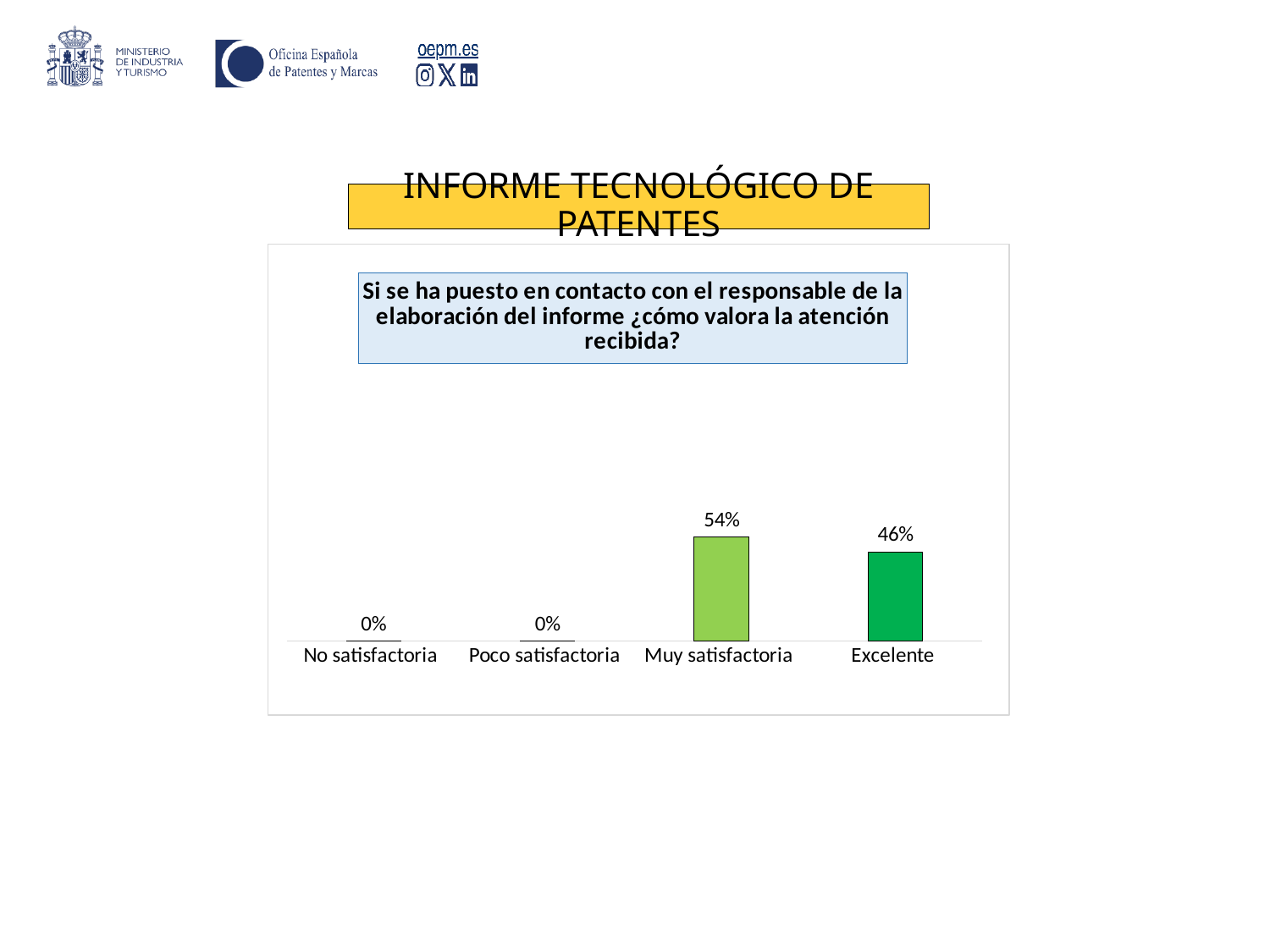
How many categories have a value of 0%? 2 Which category has the highest value? Muy satisfactoria What kind of chart is shown on the slide? Bar chart What is the difference between the values for Muy satisfactoria and Excelente? 8% What is the title of the chart? Si se ha puesto en contacto con el responsable de la elaboración del informe ¿cómo valora la atención recibida? What is the value for Muy satisfactoria? 54% What is the total of the values for Muy satisfactoria and Excelente? 100% What is the value for Poco satisfactoria? 0% Which is larger, the value for Muy satisfactoria or the value for Excelente? Muy satisfactoria What is the value for No satisfactoria? 0% What is the value for Excelente? 46% How many categories are shown on the x axis? 4